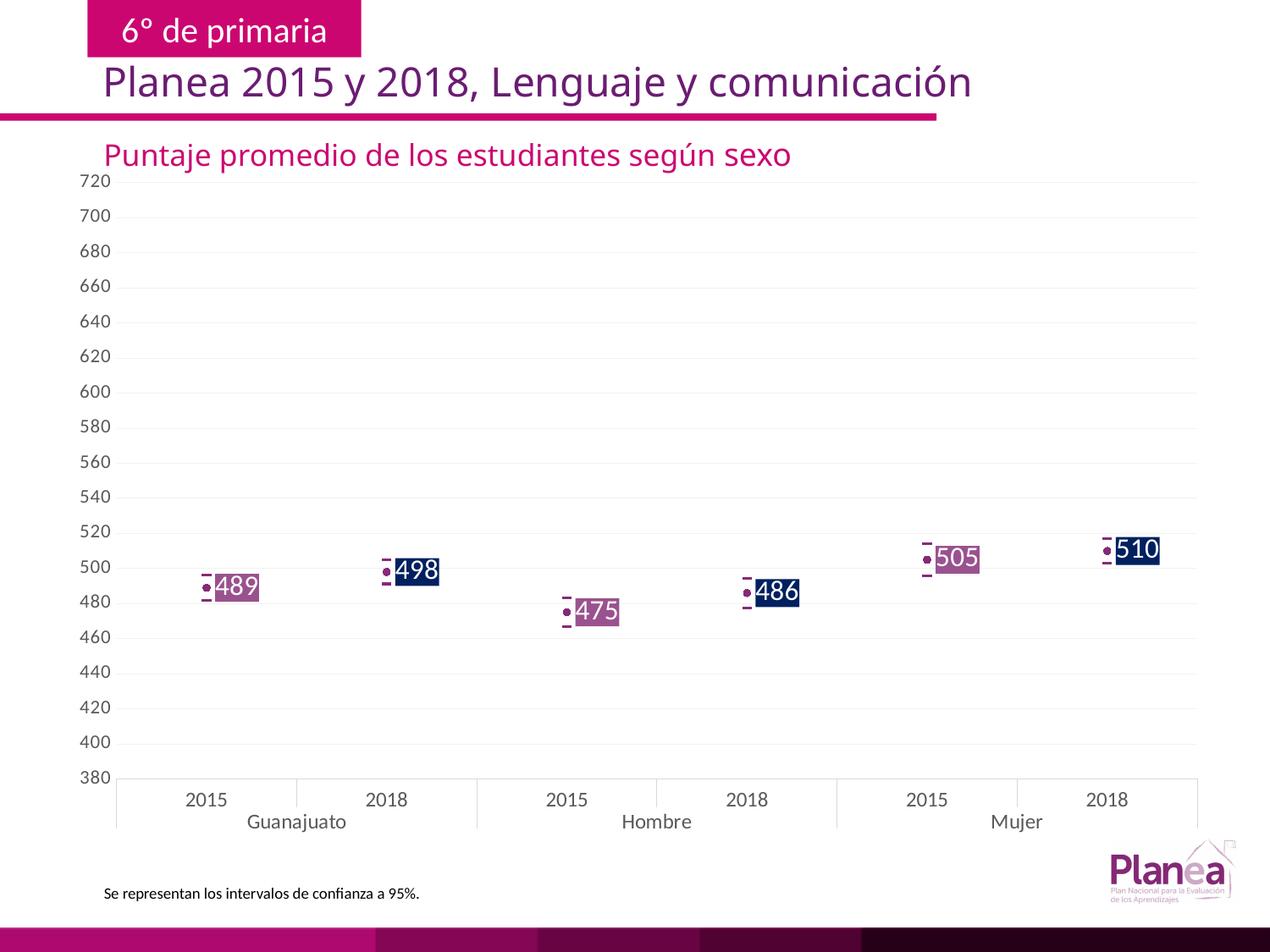
What is the average score for Guanajuato in 2015? 489 Which group and year has the lowest average score? Hombre 2015 How many data points are plotted on the chart? 6 Do the scores rise or fall from 2015 to 2018 within each group? rise Which is larger, the Guanajuato 2018 score or the Mujer 2015 score? Mujer 2015 Is the value for Hombre 2015 greater or less than 480? less What is the title of the chart? Puntaje promedio de los estudiantes según sexo Which group and year has the highest average score? Mujer 2018 What is the average score for Hombre in 2018? 486 What is the average score for Mujer in 2015? 505 What is the difference between the Mujer 2018 score and the Hombre 2015 score? 35 By how much did the Hombre score increase from 2015 to 2018? 11